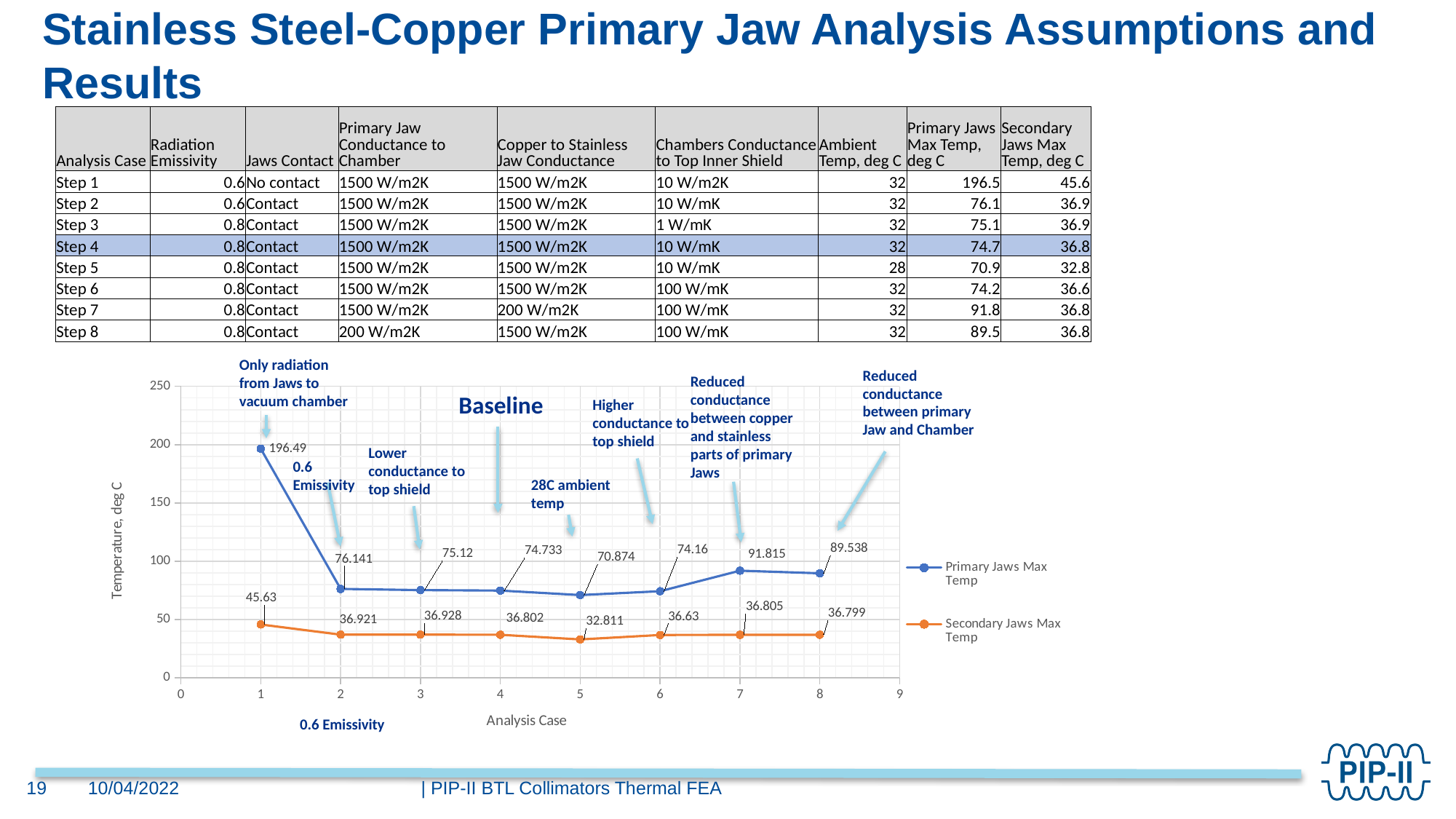
How many analysis cases are plotted for each series in the chart? 8 What is the Secondary Jaws Max Temp value at analysis case 5? 32.811 At which analysis case is the Primary Jaws Max Temp highest? 1 What type of chart is shown on the slide? line chart What is the difference between the Primary Jaws Max Temp at case 1 and at case 2? 120.349 What is the Primary Jaws Max Temp value at analysis case 7? 91.815 Is the Primary Jaws Max Temp at analysis case 4 greater or less than 100? less Which is larger: the Primary Jaws Max Temp at case 7 or at case 8? case 7 How many series does the chart legend list? 2 What is the label of the chart's y axis? Temperature, deg C What is the Primary Jaws Max Temp value at analysis case 1? 196.49 At which analysis case is the Secondary Jaws Max Temp lowest? 5